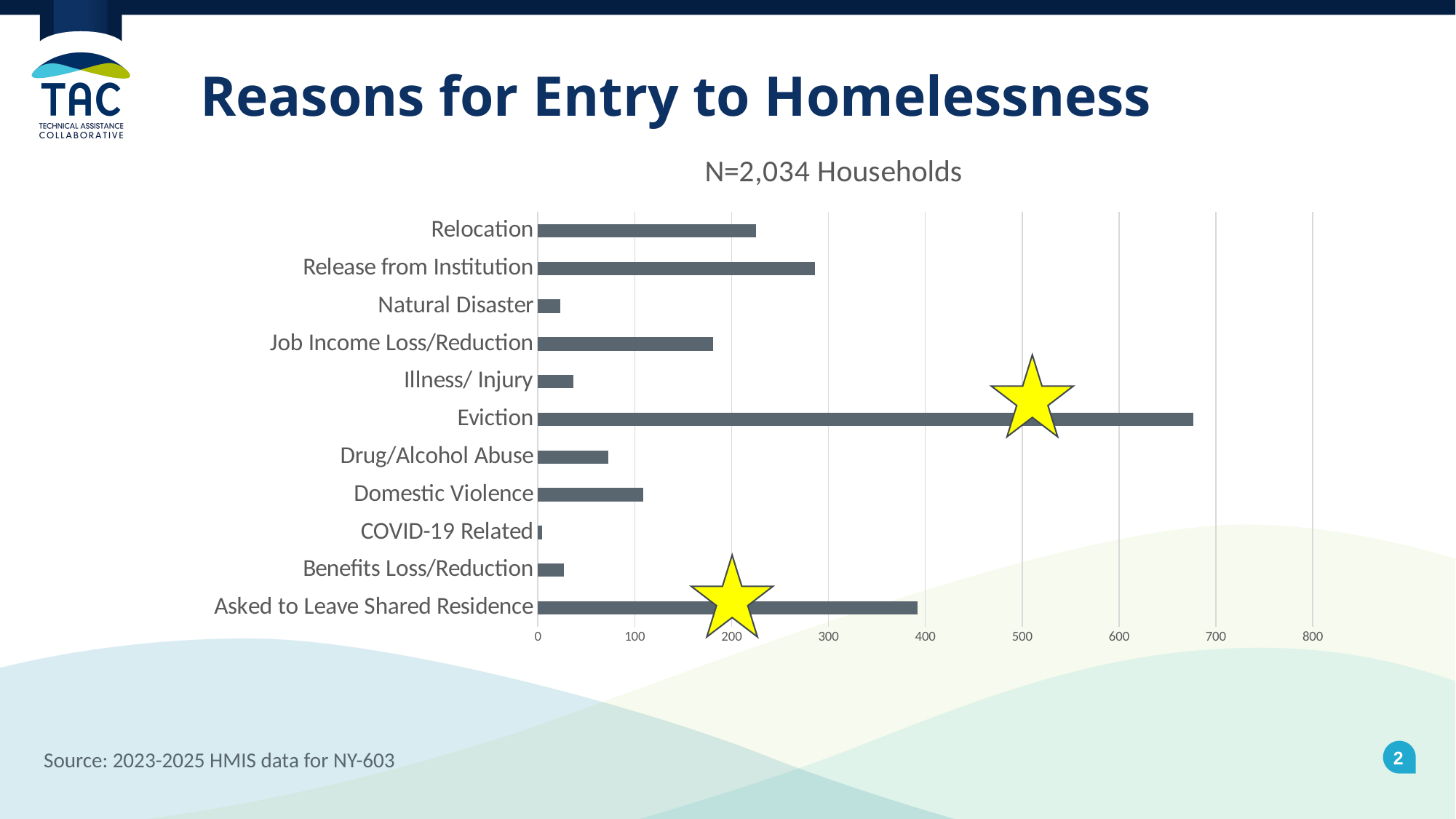
What type of chart is shown on the slide? bar chart Is the value for Asked to Leave Shared Residence greater or less than 400? less How many reasons (categories) are plotted on the chart? 11 What is the highest value shown on the horizontal axis of the chart? 800 Is the value for Natural Disaster greater or less than 100? less Which reason for entry to homelessness has the highest value? Eviction Is the value for Release from Institution greater or less than 200? greater Which is larger, the value for Relocation or the value for Job Income Loss/Reduction? Relocation What is the title shown above the chart? N=2,034 Households Which is larger, the value for Domestic Violence or the value for Drug/Alcohol Abuse? Domestic Violence Which reason for entry to homelessness has the lowest value? COVID-19 Related